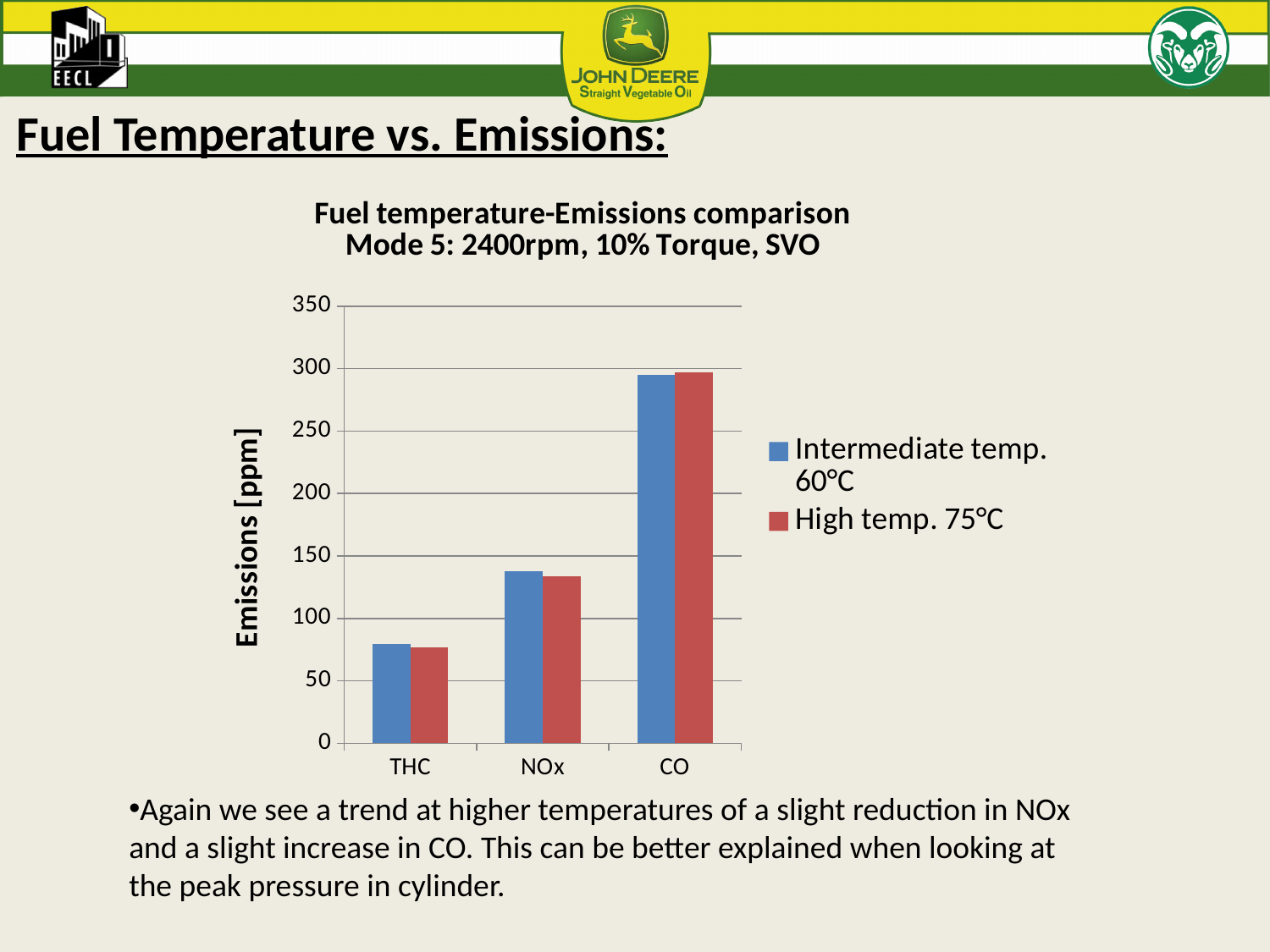
Is the value for THC at High temp. 75°C greater or less than 100? less Which emission category has the lowest values? THC What are the two series named in the legend? Intermediate temp. 60°C and High temp. 75°C Is the value for NOx at High temp. 75°C greater or less than 150? less What is the label of the y axis? Emissions [ppm] Which is larger, the CO value or the NOx value at High temp. 75°C? CO What kind of chart is shown on the slide? bar chart How many emission categories are shown on the x axis? 3 Which emission category has the highest values? CO Is the value for CO at Intermediate temp. 60°C greater or less than 250? greater How many series does the legend list? 2